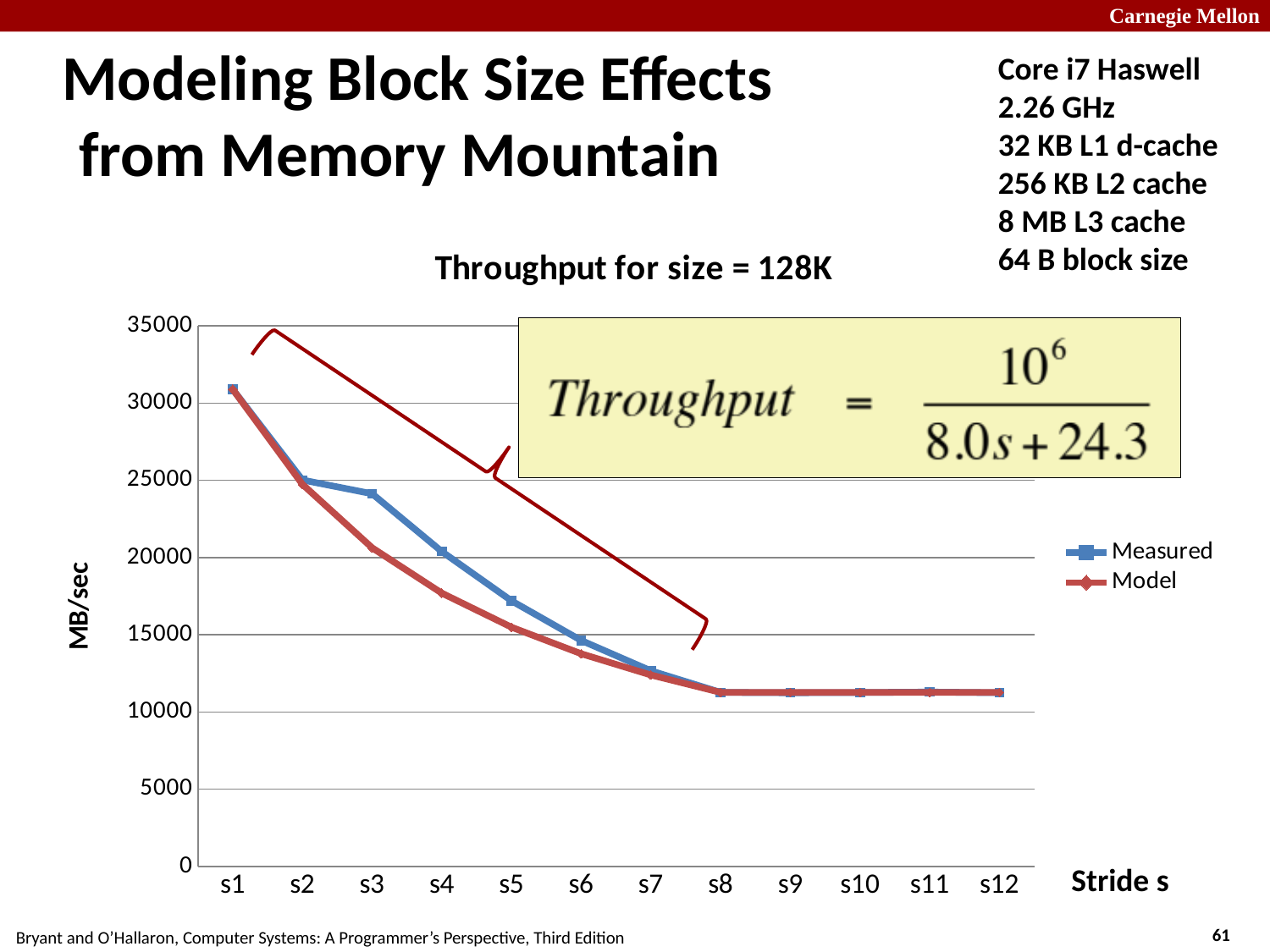
Is the Measured value at s8 greater or less than 15000? less What is the label on the y axis? MB/sec How many series does the legend list? 2 What kind of chart is shown on the slide? line chart Is the Measured value at s3 greater or less than 20000? greater At which stride is the Measured throughput highest? s1 How many stride categories are plotted along the x axis? 12 At stride s3, which series has the larger value, Measured or Model? Measured What is the title of the chart? Throughput for size = 128K Is the Model value at s3 greater or less than 25000? less Do the Measured values rise or fall as the stride increases from s1 to s8? fall